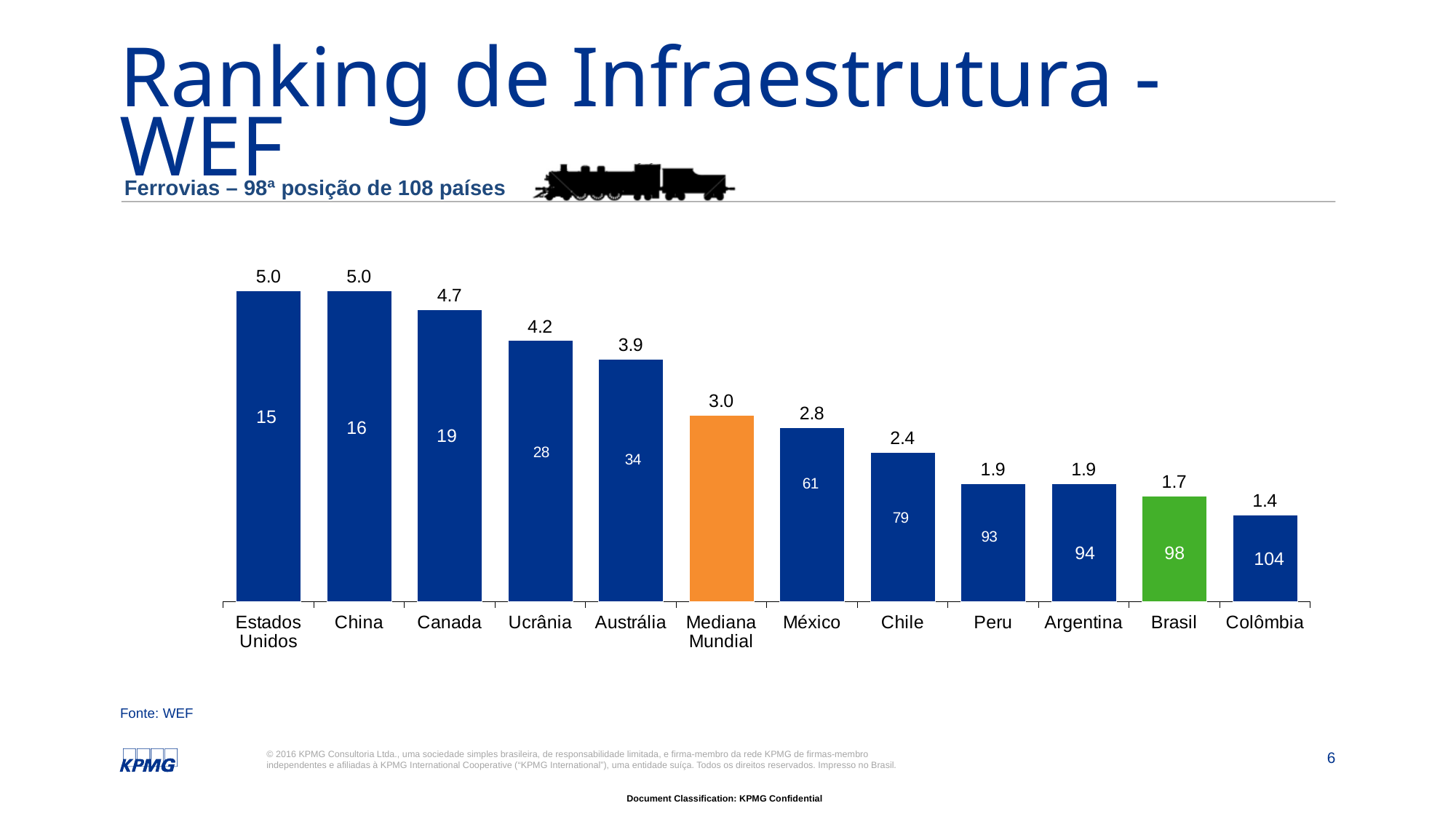
Which country has the lowest score in the chart? Colômbia Do the scores rise or fall from left to right across the chart? Fall What ranking position is printed inside the bar for Brasil? 98 What score is shown above the bar for Brasil? 1.7 What ranking position is printed inside the bar for Colômbia? 104 How many bars are shown in the chart? 12 What kind of chart is shown on the slide? Bar chart Which bar in the chart is coloured green? Brasil What is the difference between the score for Mediana Mundial and the score for Brasil? 1.3 What is the difference between the score for Canada and the score for Chile? 2.3 Which has a higher score, Ucrânia or Austrália? Ucrânia What score is shown above the bar for Mediana Mundial? 3.0